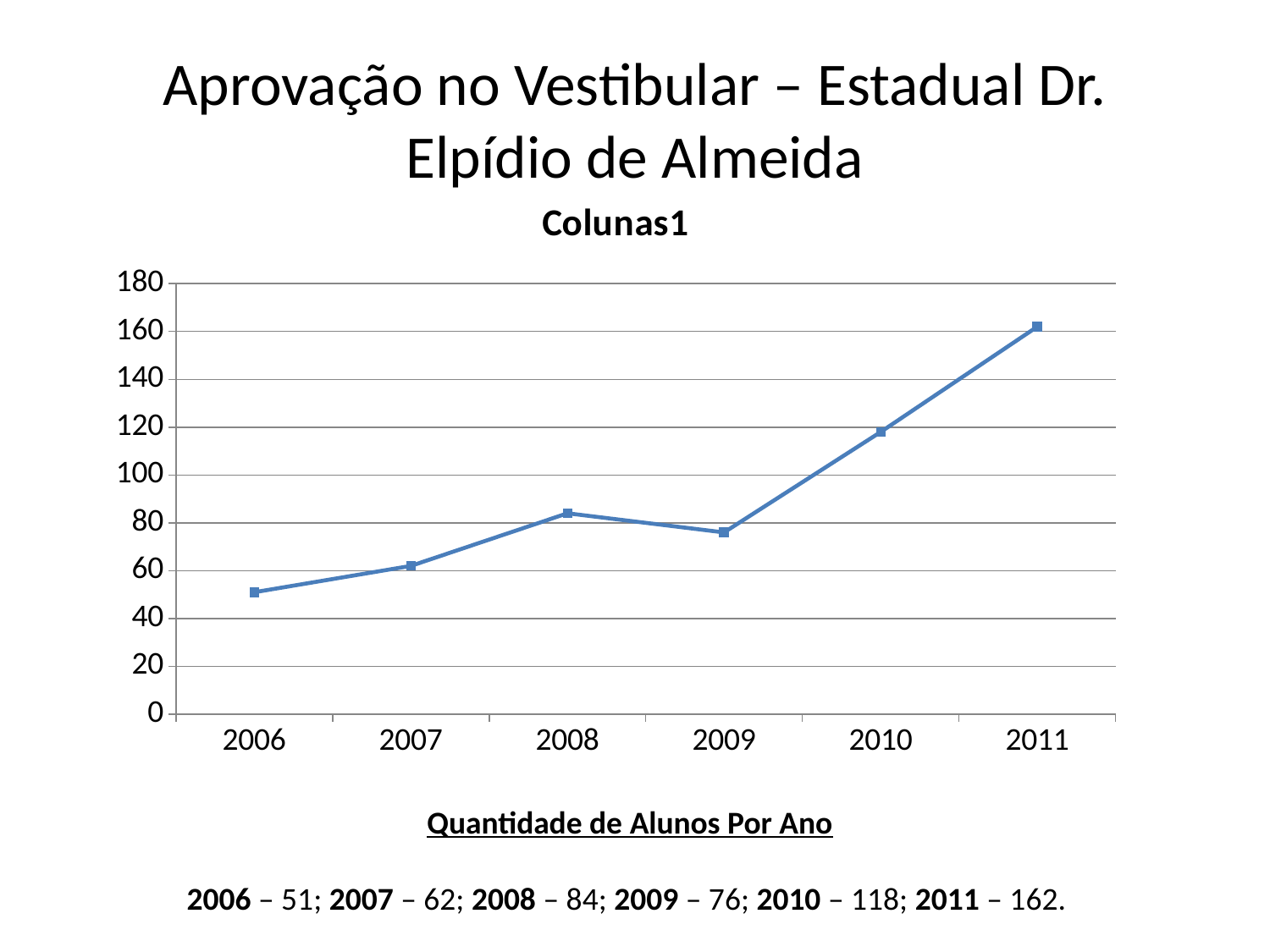
What is the title shown above the chart? Colunas1 Which year has the lowest value? 2006 What kind of chart is shown on the slide? line chart Which is larger, the value for 2008 or the value for 2009? 2008 What is the difference between the values for 2011 and 2010? 44 What is the value for 2010? 118 What is the difference between the values for 2008 and 2009? 8 How many years are plotted on the x axis? 6 What is the value for 2009? 76 What is the value for 2006? 51 Which year has the highest value? 2011 Is the value for 2011 greater or less than 140? greater